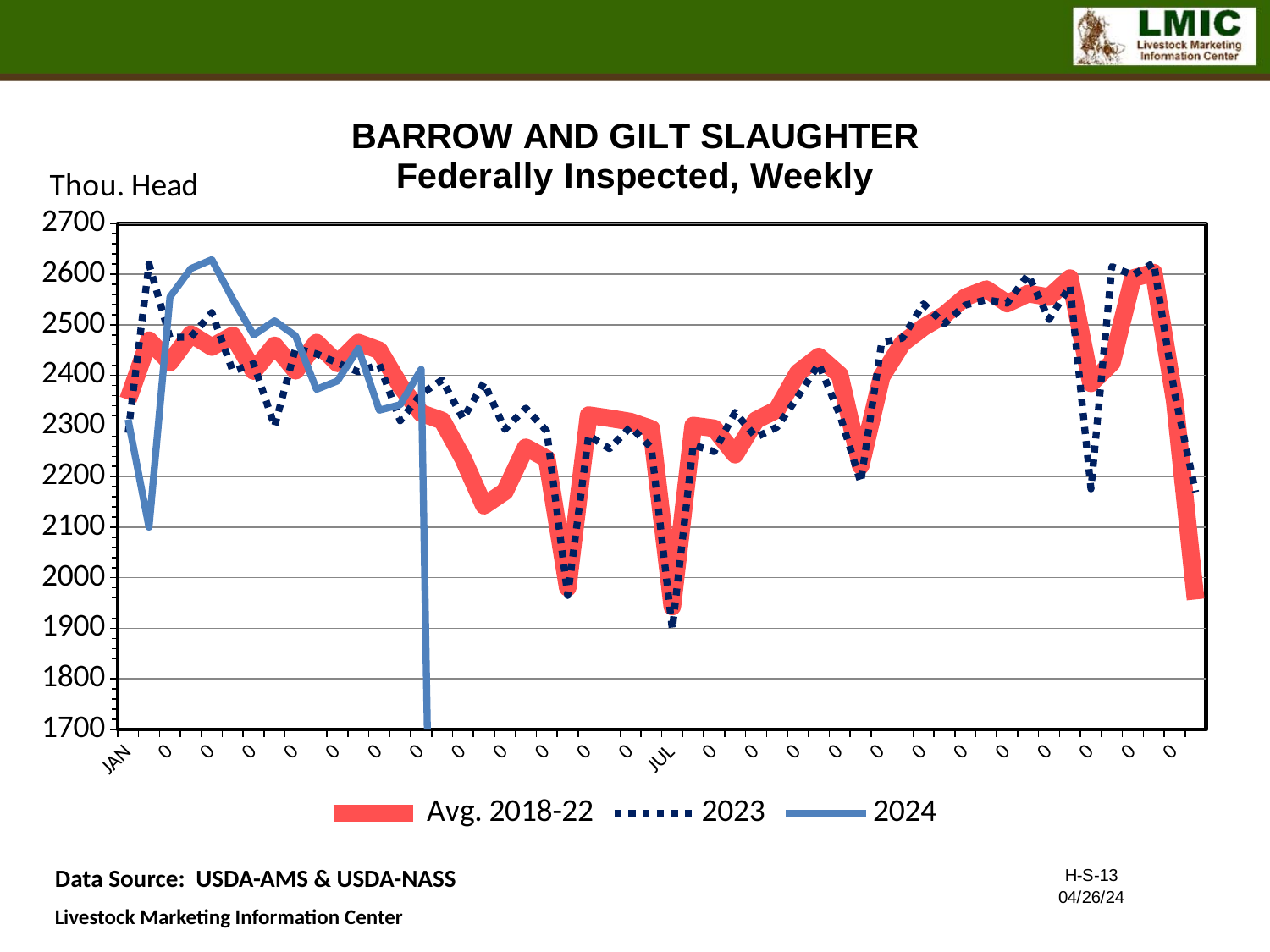
How many series does the legend list? 3 What kind of chart is shown on the slide? Line chart Is the lowest point of the Avg. 2018-22 line greater or less than 2100? less Is the highest point of the Avg. 2018-22 line greater or less than 2500? greater What are the three series named in the legend? Avg. 2018-22, 2023, 2024 Which series is drawn as a dotted line? 2023 Is the lowest point of the 2023 line greater or less than 2000? less What is the unit label shown on the vertical axis? Thou. Head